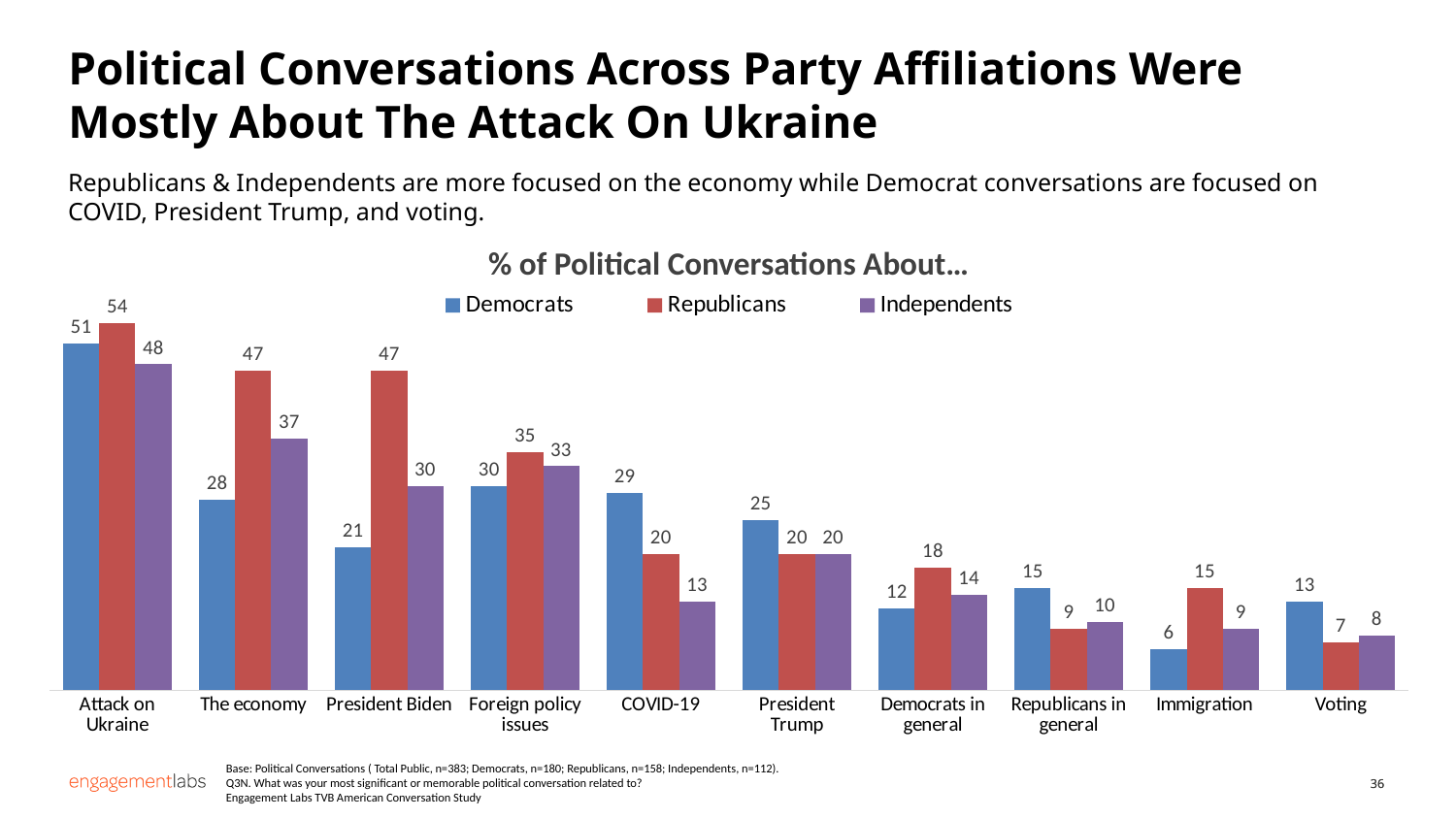
Which category has the lowest value for Republicans? Voting What is the value for Independents for The economy? 37 What is the title of the chart? % of Political Conversations About… What is the difference between the Republicans and Democrats values for President Biden? 26 What kind of chart is shown on the slide? Bar chart How many series does the legend list? 3 What is the value for Republicans for Attack on Ukraine? 54 For Immigration, which is larger: the Democrats value or the Republicans value? Republicans What is the value for Democrats for COVID-19? 29 Which category has the highest value for Democrats? Attack on Ukraine Which colour represents Independents in the chart? Purple How many categories are shown on the x axis? 10